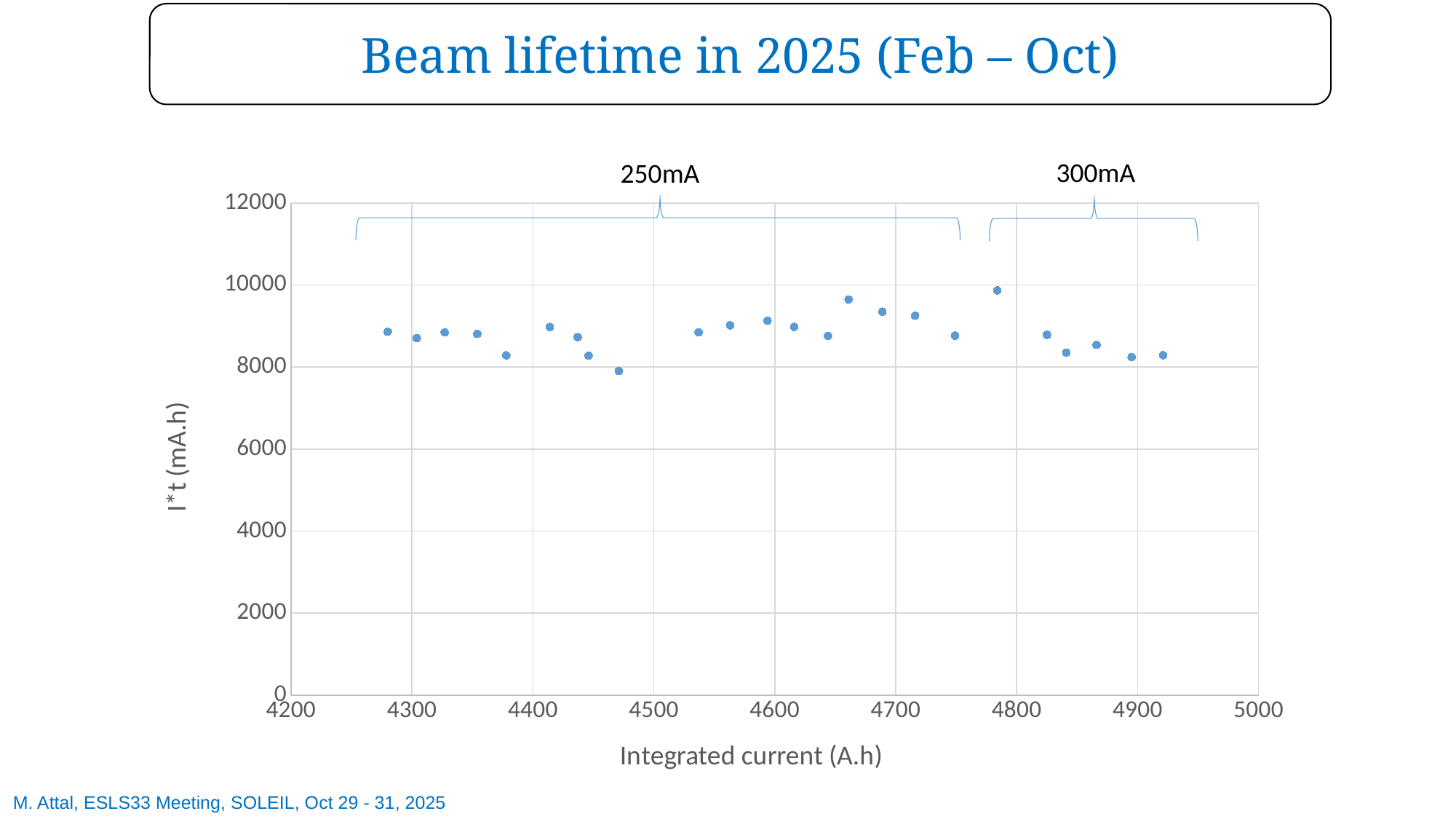
What is the title of the chart on the slide? Beam lifetime in 2025 (Feb – Oct) Is the value of the point near 4785 A.h greater or less than 8000? greater Which point has the highest I*t value: the one near 4785 A.h or the one near 4470 A.h? The one near 4785 A.h How many data points are plotted on the chart? 24 What is the label of the x axis of the chart? Integrated current (A.h) Do the values in the 300mA region rise or fall as integrated current increases from about 4785 to 4895 A.h? Fall What is the maximum value shown on the y axis? 12000 Are all the plotted points above 6000 mA.h? Yes Is the value of the point near 4660 A.h greater or less than 10000? less What kind of chart is shown on the slide? Scatter chart Which point has the lowest I*t value: the one near 4470 A.h or the one near 4895 A.h? The one near 4470 A.h